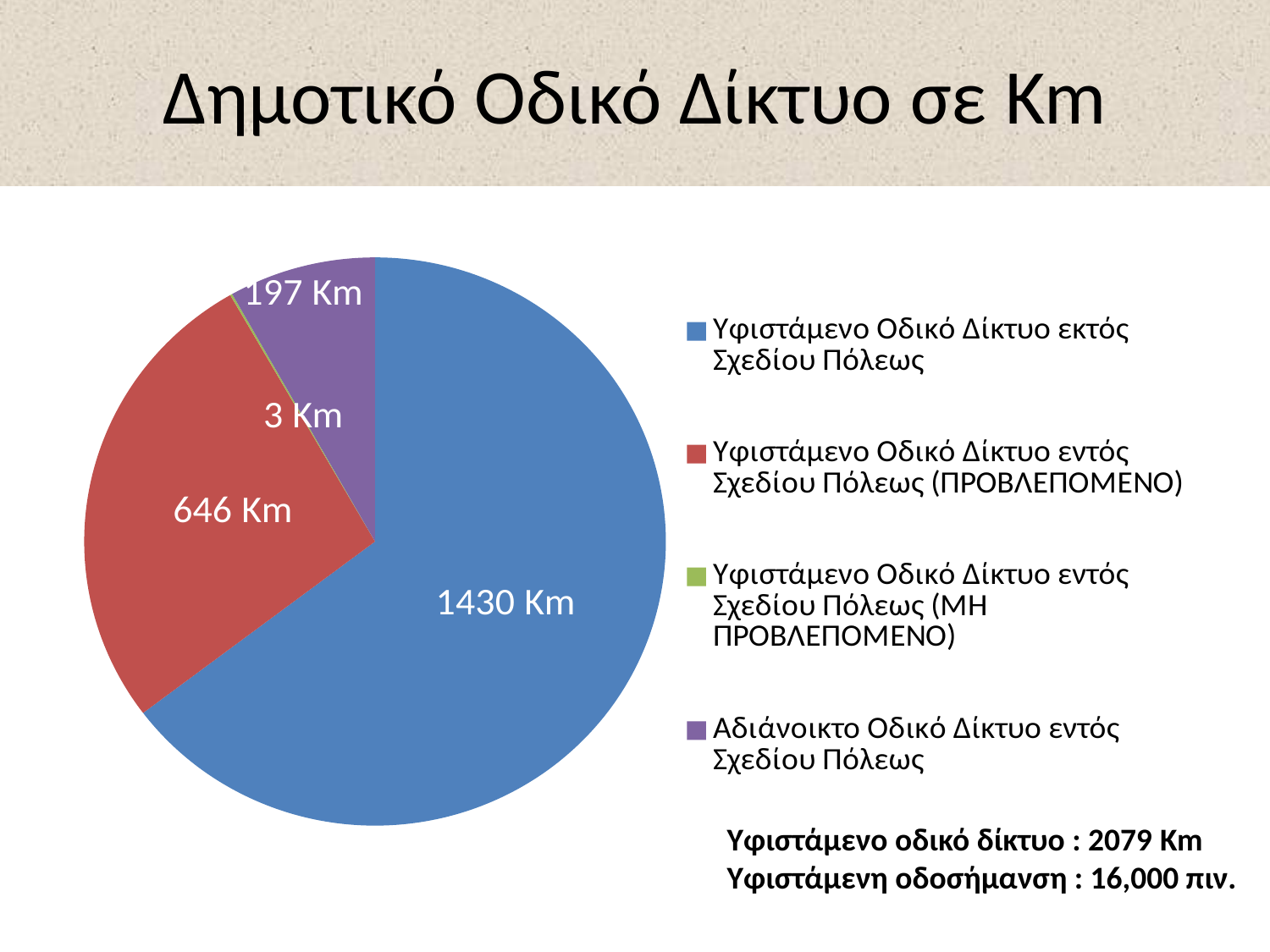
Which is larger: the value for Υφιστάμενο Οδικό Δίκτυο εντός Σχεδίου Πόλεως (ΠΡΟΒΛΕΠΟΜΕΝΟ) or the value for Αδιάνοικτο Οδικό Δίκτυο εντός Σχεδίου Πόλεως? Υφιστάμενο Οδικό Δίκτυο εντός Σχεδίου Πόλεως (ΠΡΟΒΛΕΠΟΜΕΝΟ) What is the value for Αδιάνοικτο Οδικό Δίκτυο εντός Σχεδίου Πόλεως? 197 Km Which category has the smallest slice of the pie? Υφιστάμενο Οδικό Δίκτυο εντός Σχεδίου Πόλεως (ΜΗ ΠΡΟΒΛΕΠΟΜΕΝΟ) What is the value for Υφιστάμενο Οδικό Δίκτυο εντός Σχεδίου Πόλεως (ΜΗ ΠΡΟΒΛΕΠΟΜΕΝΟ)? 3 Km What is the value for Υφιστάμενο Οδικό Δίκτυο εντός Σχεδίου Πόλεως (ΠΡΟΒΛΕΠΟΜΕΝΟ)? 646 Km How many categories does the pie chart have? 4 Which category has the largest slice of the pie? Υφιστάμενο Οδικό Δίκτυο εκτός Σχεδίου Πόλεως What kind of chart is shown on the slide? Pie chart What colour is the slice for Αδιάνοικτο Οδικό Δίκτυο εντός Σχεδίου Πόλεως? Purple What is the value for Υφιστάμενο Οδικό Δίκτυο εκτός Σχεδίου Πόλεως? 1430 Km What is the difference between the value for Υφιστάμενο Οδικό Δίκτυο εκτός Σχεδίου Πόλεως and the value for Υφιστάμενο Οδικό Δίκτυο εντός Σχεδίου Πόλεως (ΠΡΟΒΛΕΠΟΜΕΝΟ)? 784 Km What is the title of the slide containing the chart? Δημοτικό Οδικό Δίκτυο σε Km